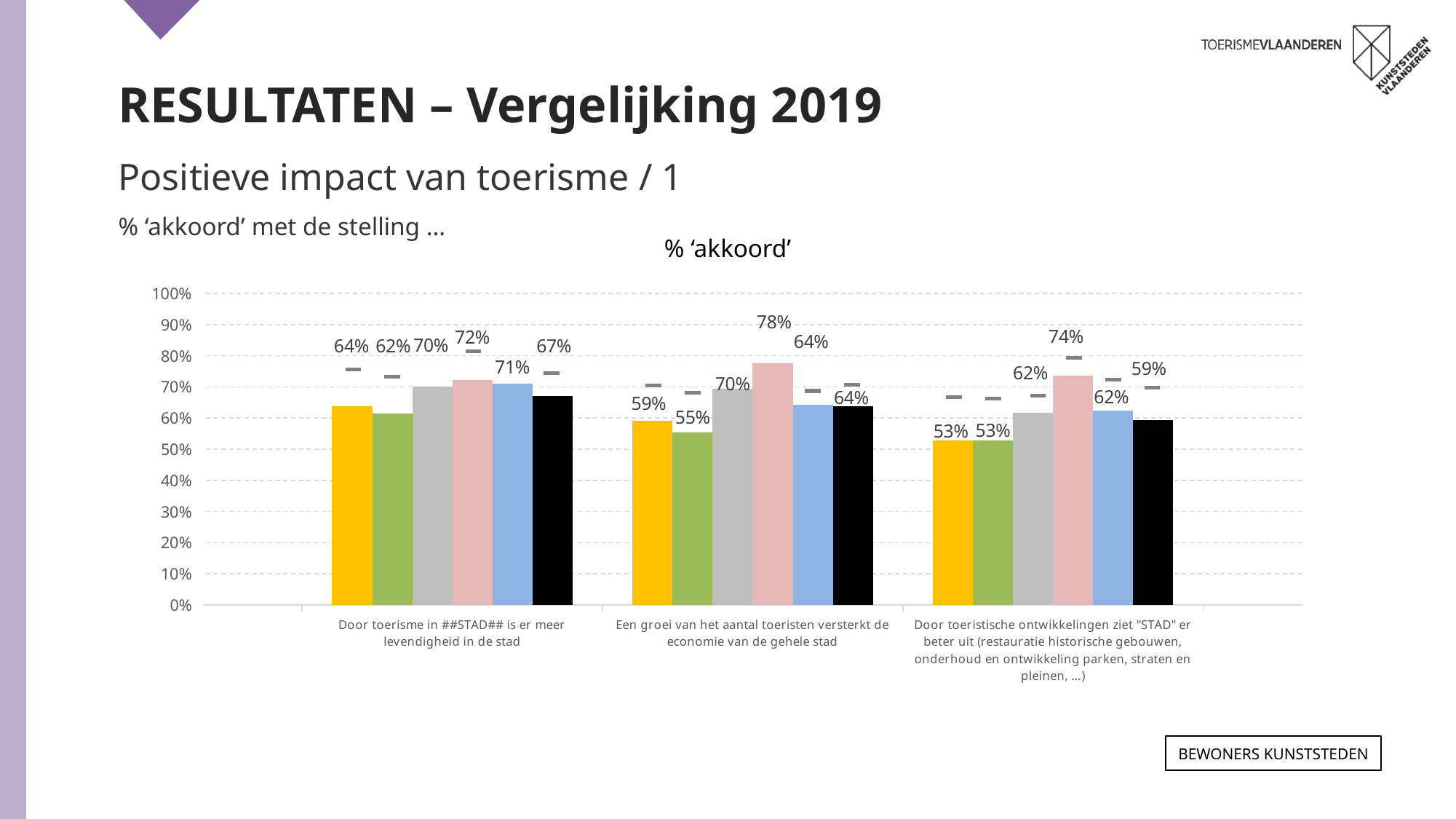
What kind of chart is shown on the slide? bar chart How many statement categories are shown on the x axis? 3 What is the difference between the blue bar and the yellow bar for the statement 'Door toerisme in ##STAD## is er meer levendigheid in de stad'? 7% What is the value of the black bar for the statement 'Door toeristische ontwikkelingen ziet "STAD" er beter uit'? 59% What is the value of the pink bar for the statement 'Een groei van het aantal toeristen versterkt de economie van de gehele stad'? 78% Which bar is the highest for the statement 'Door toeristische ontwikkelingen ziet "STAD" er beter uit'? the pink bar (74%) What is the chart's title? % ‘akkoord’ Which bar is the lowest for the statement 'Een groei van het aantal toeristen versterkt de economie van de gehele stad'? the green bar (55%) For the statement 'Door toerisme in ##STAD## is er meer levendigheid in de stad', which is larger: the grey bar or the black bar? the grey bar (70%) What is the value of the yellow bar for the statement 'Door toerisme in ##STAD## is er meer levendigheid in de stad'? 64% What is the difference between the pink bar and the green bar for the statement 'Een groei van het aantal toeristen versterkt de economie van de gehele stad'? 23% Is the value of the yellow bar for the statement 'Door toeristische ontwikkelingen ziet "STAD" er beter uit' greater or less than 60%? less